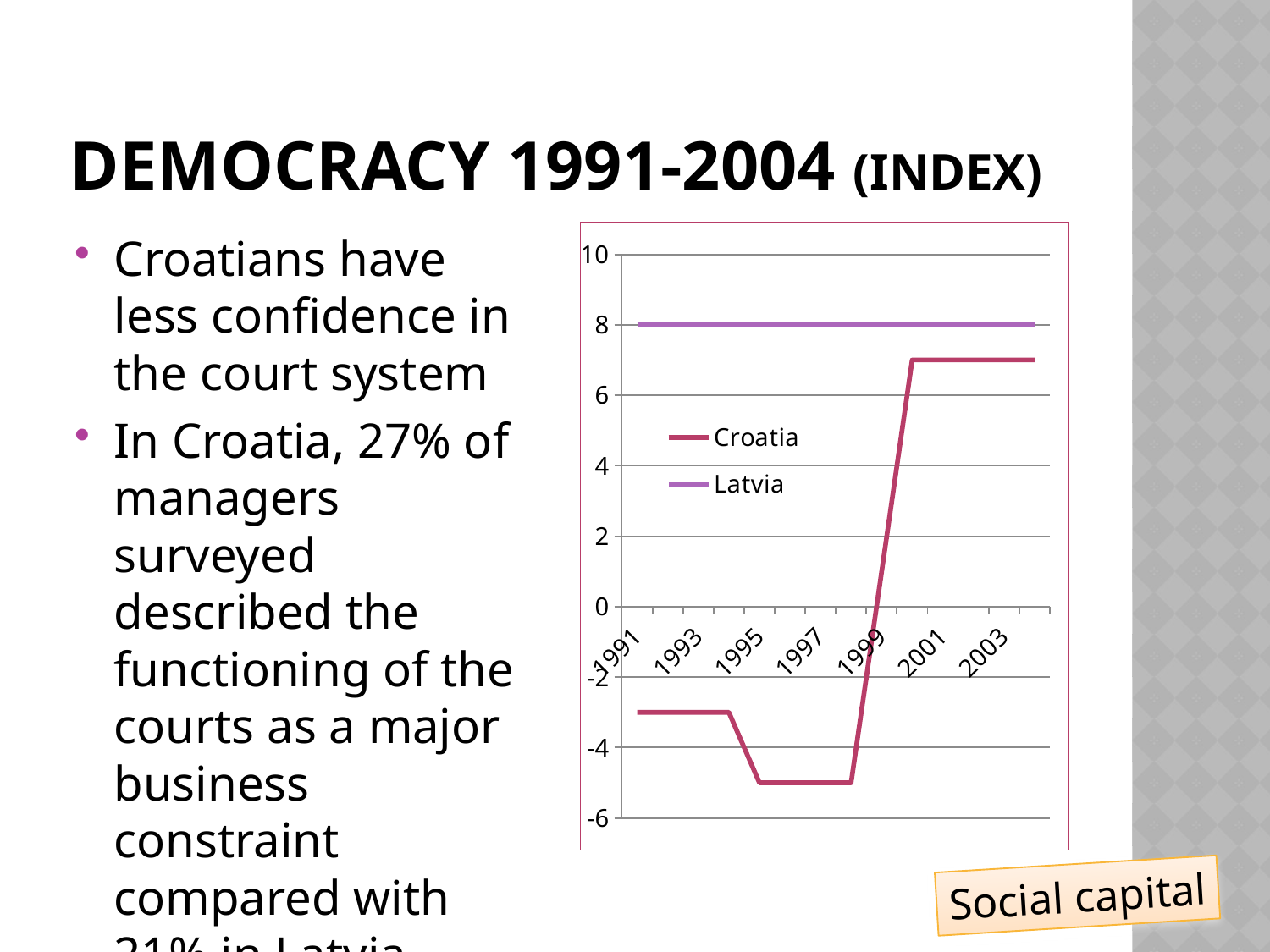
What is the value for Latvia in 1993? 8 Does the Latvia line rise, fall, or stay flat across the years shown? stays flat Which series has the higher value in 1995, Croatia or Latvia? Latvia Does the Croatia line rise or fall between 1999 and 2001? rises Is the value for Croatia in 2003 greater or less than 6? greater How many series does the chart's legend list? 2 What kind of chart is shown on the slide? line chart Which two countries are listed in the chart's legend? Croatia and Latvia Is the value for Croatia in 1991 greater or less than -4? greater Is the value for Croatia in 1997 greater or less than -4? less Which series has the higher value in 2003? Latvia What is the value for Latvia in 2003? 8